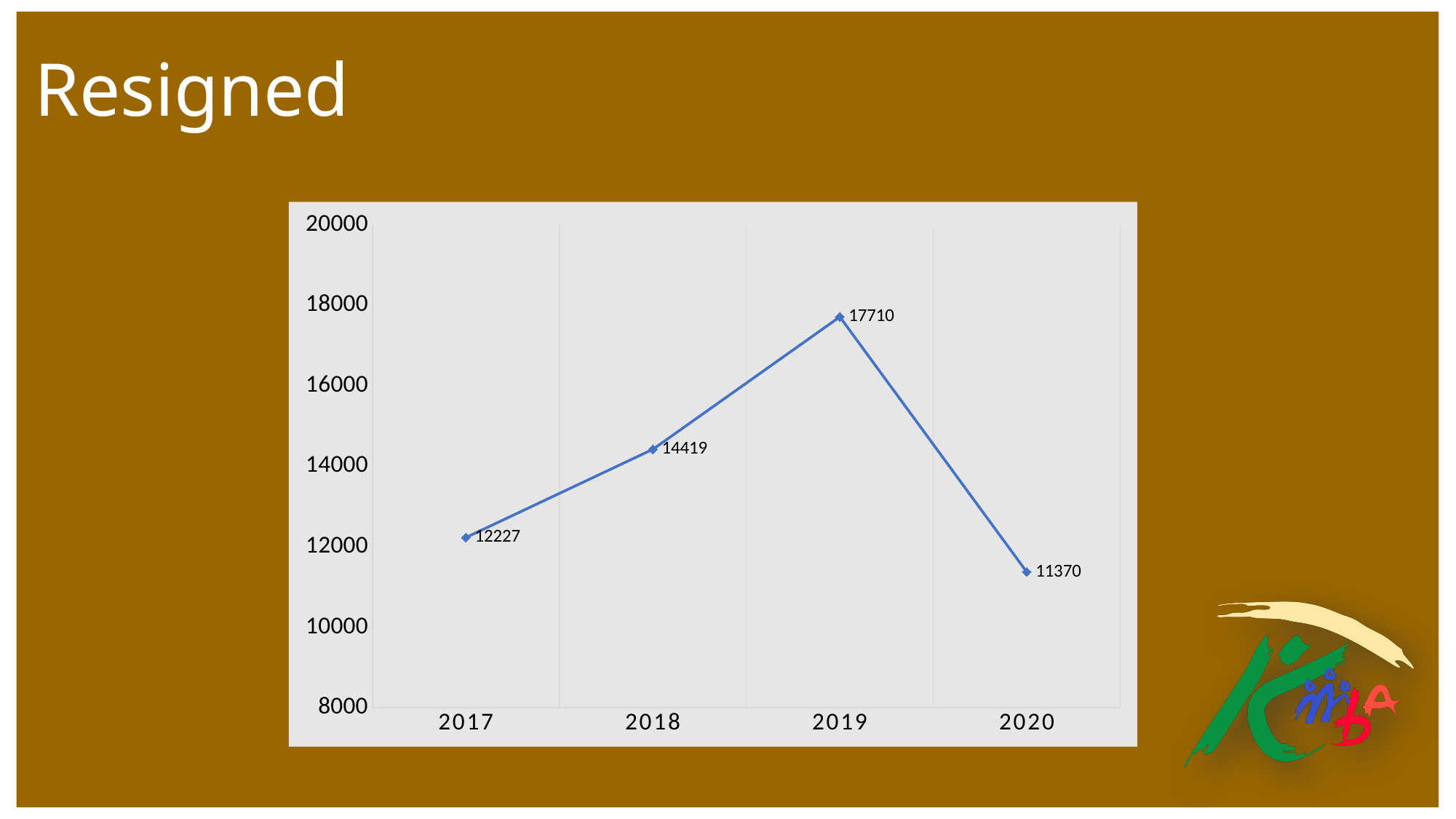
What is the difference between the values for 2019 and 2018? 3291 What kind of chart is shown on the slide? line chart Do the values rise or fall from 2019 to 2020? fall Which year has the lowest value? 2020 How many data points are plotted on the chart? 4 What is the value for 2017? 12227 What is the difference between the values for 2017 and 2020? 857 What is the value for 2019? 17710 What is the value for 2020? 11370 Which is larger, the value for 2018 or the value for 2020? 2018 Which year has the highest value? 2019 What is the value for 2018? 14419